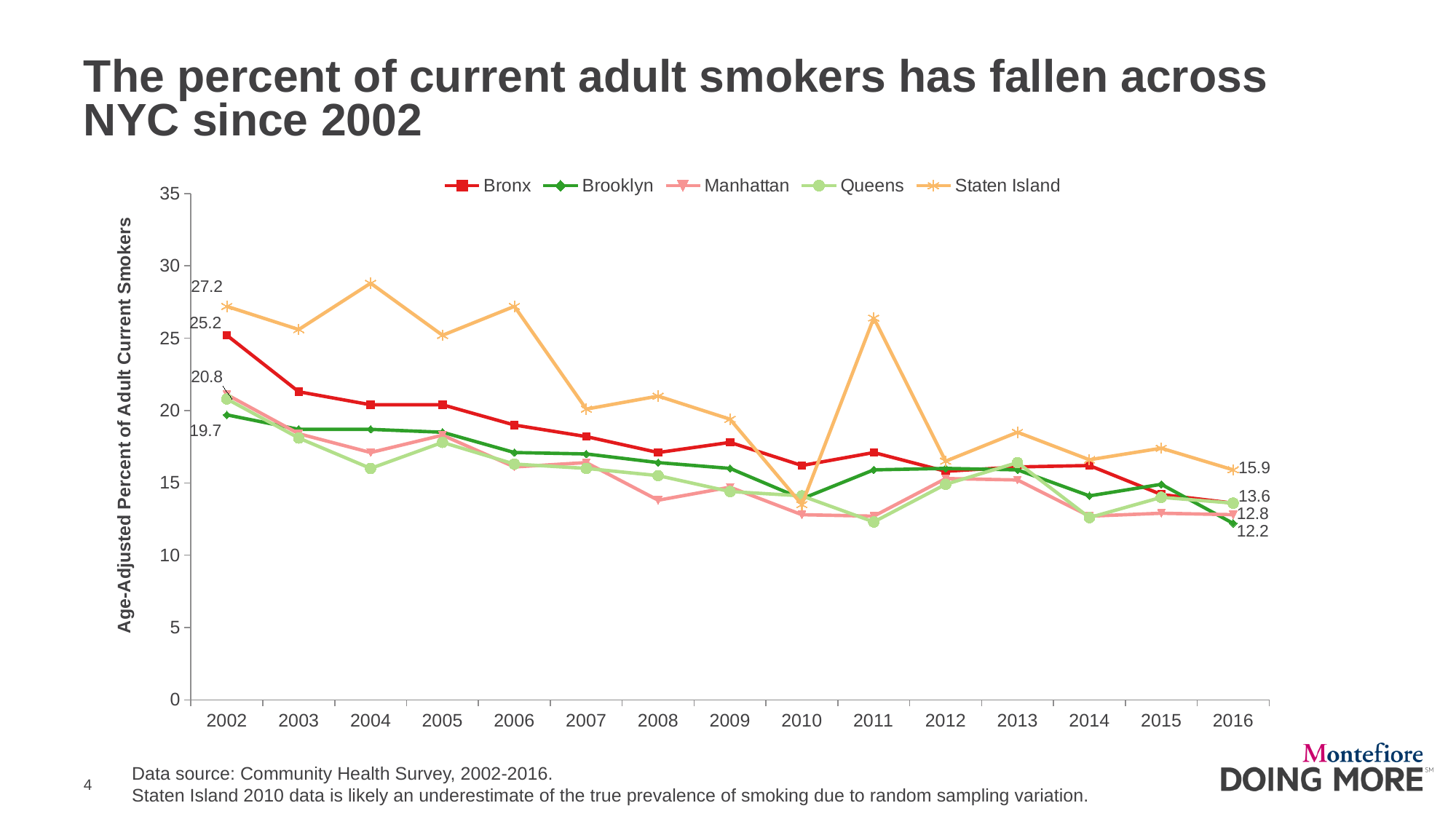
By how many percentage points did Staten Island's value fall from 2002 to 2016? 11.3 What was the age-adjusted percent of adult current smokers in Staten Island in 2016? 15.9 What was the age-adjusted percent of adult current smokers in Staten Island in 2002? 27.2 How many series does the legend list? 5 Is the value for Staten Island in 2004 greater or less than 25? greater How many years are plotted along the x axis? 15 Which borough had the highest percent of adult current smokers in 2002? Staten Island What was the age-adjusted percent of adult current smokers in the Bronx in 2002? 25.2 What was the age-adjusted percent of adult current smokers in Brooklyn in 2016? 12.2 What type of chart is shown on the slide? Line chart Overall, do the values for the Bronx rise or fall from 2002 to 2016? Fall Which borough had the lowest percent of adult current smokers in 2016? Brooklyn